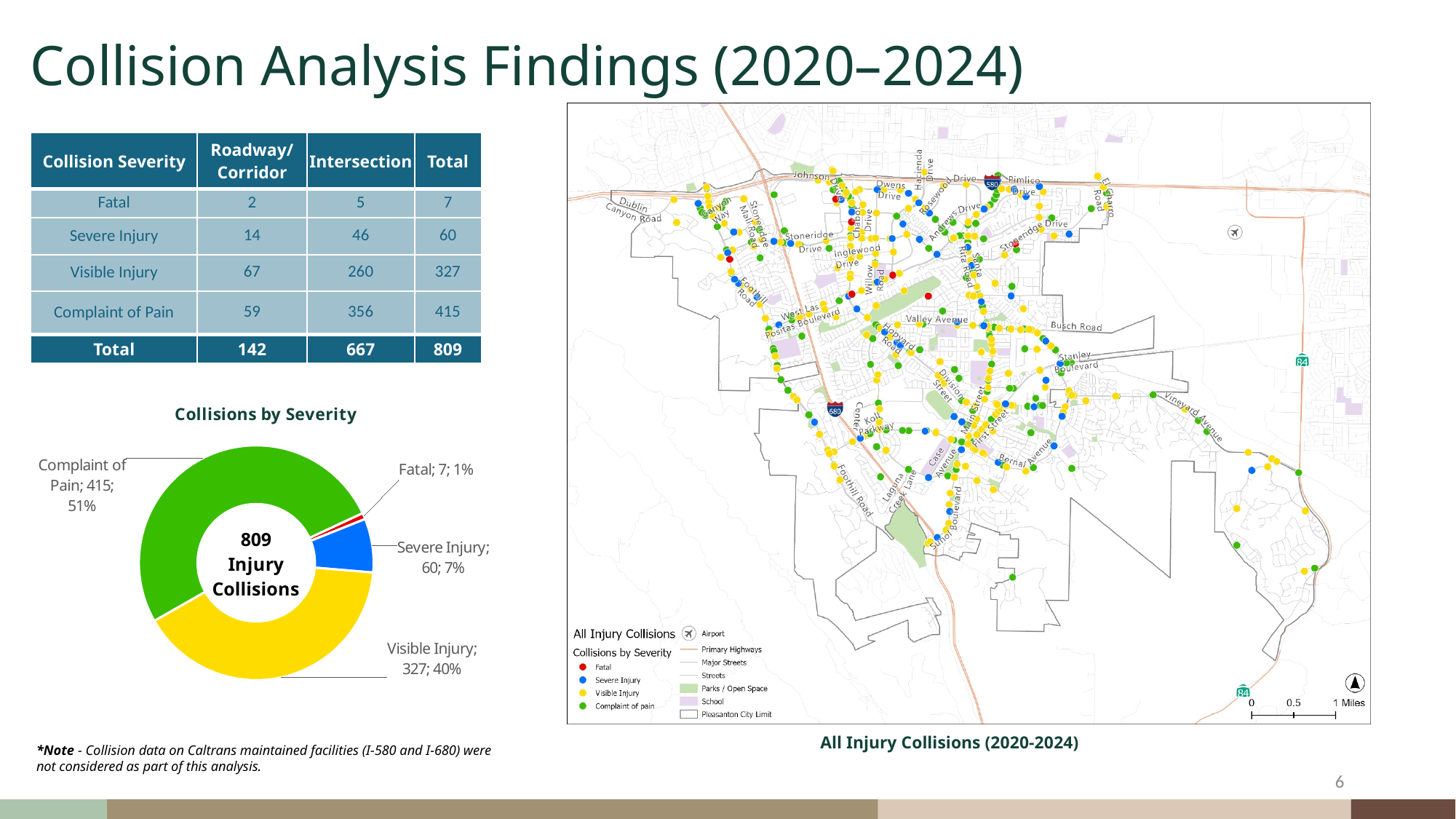
What colour represents Visible Injury in the "Collisions by Severity" chart? Yellow How many severity categories are shown in the "Collisions by Severity" chart? 4 Which category in the "Collisions by Severity" chart has the largest share? Complaint of Pain In the "Collisions by Severity" chart, what share of collisions is Fatal? 1% In the "Collisions by Severity" chart, how many Severe Injury collisions are shown? 60 Which category in the "Collisions by Severity" chart has the smallest share? Fatal What total number of injury collisions is shown in the center of the "Collisions by Severity" chart? 809 What type of chart is the "Collisions by Severity" chart? Donut (pie) chart In the "Collisions by Severity" chart, what percentage share does Visible Injury have? 40% In the "Collisions by Severity" chart, how many collisions are in the Complaint of Pain category? 415 In the "Collisions by Severity" chart, what is the difference between the number of Complaint of Pain collisions and Visible Injury collisions? 88 In the "Collisions by Severity" chart, which is larger: Severe Injury or Fatal? Severe Injury